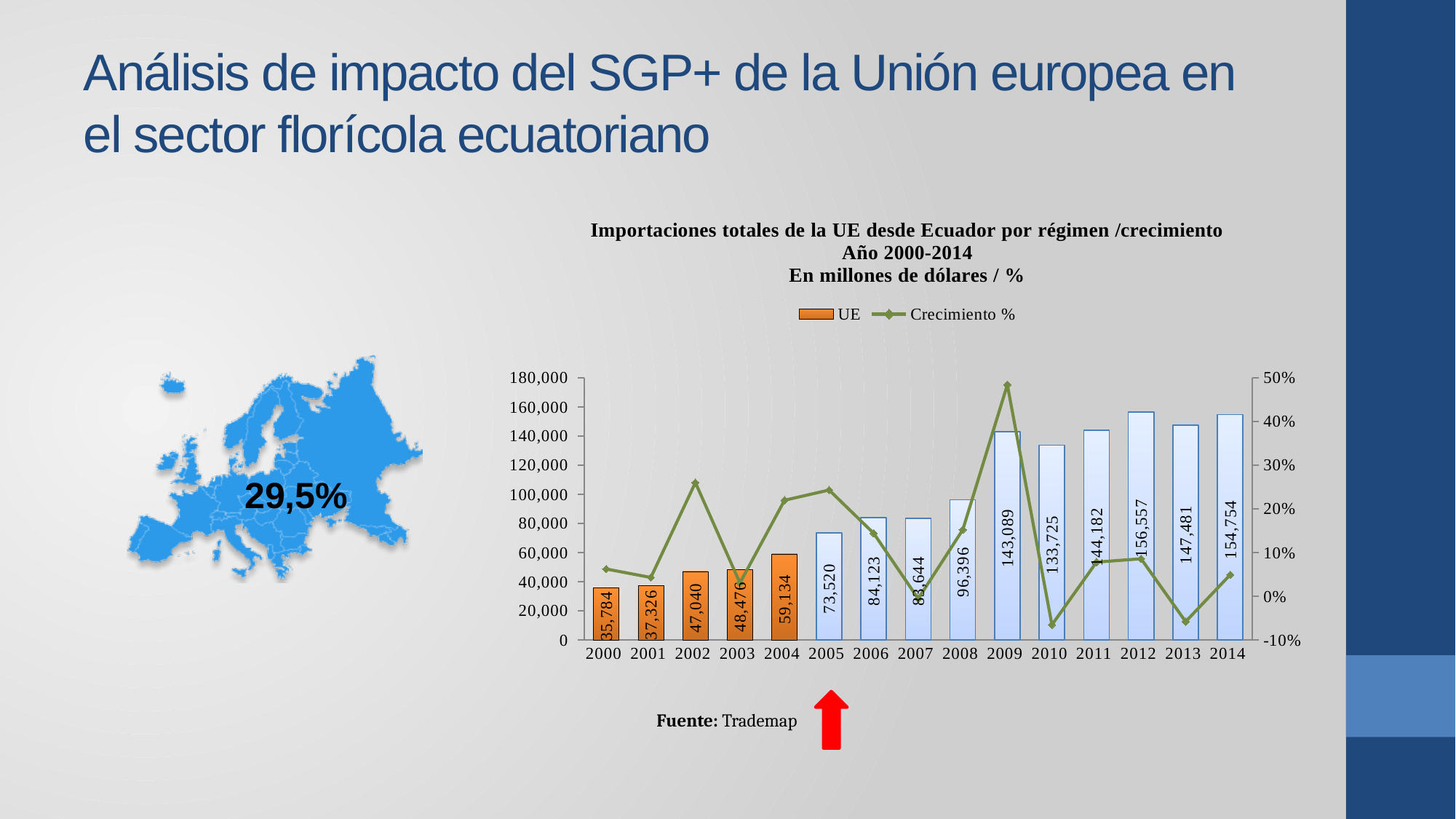
What is the difference between the UE values for 2009 and 2008? 46,693 Which year has the lowest UE value? 2000 How many years are shown on the x axis? 15 How many series does the legend list? 2 Which year has the highest UE value? 2012 What kind of chart is this? Combined bar and line chart Is the Crecimiento % value for 2010 greater or less than 0%? less What is the UE value for 2009? 143,089 What is the UE value for 2000? 35,784 What is the UE value for 2014? 154,754 Which is larger, the UE value for 2011 or for 2010? 2011 Is the Crecimiento % value for 2009 greater or less than 40%? greater